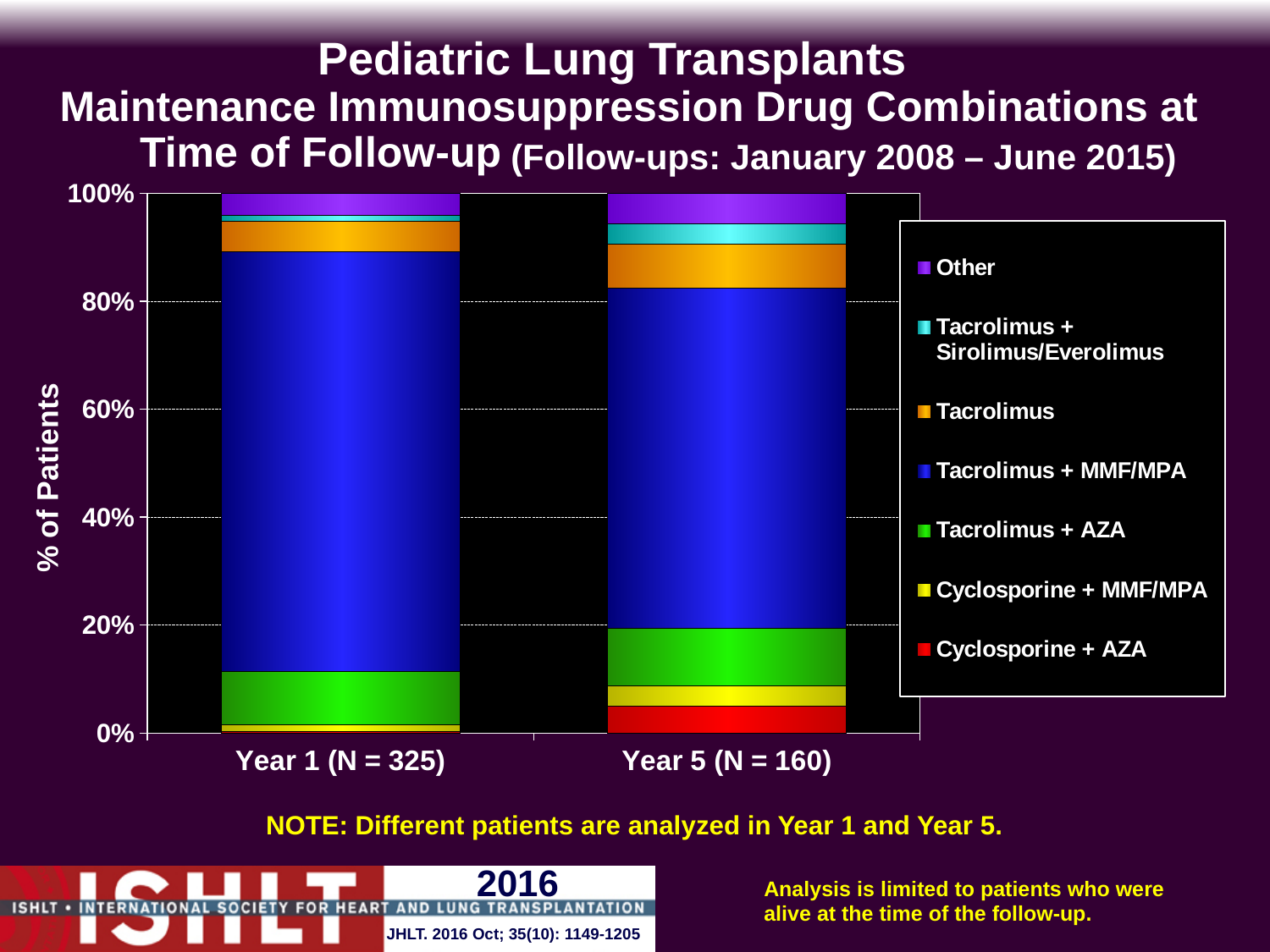
Is the share of Tacrolimus + MMF/MPA in Year 5 (N = 160) greater or less than 40%? greater How many bars (categories) are plotted on the x axis? 2 Is the share of Tacrolimus + AZA in Year 5 (N = 160) greater or less than 20%? less How many series does the legend list? 7 Does the share of Tacrolimus + MMF/MPA rise or fall from Year 1 to Year 5? fall Is the share of Cyclosporine + AZA larger in Year 1 (N = 325) or Year 5 (N = 160)? Year 5 (N = 160) Is the share of Tacrolimus + MMF/MPA larger in Year 1 (N = 325) or Year 5 (N = 160)? Year 1 (N = 325) Is the share of Tacrolimus + MMF/MPA in Year 1 (N = 325) greater or less than 60%? greater What is the label on the y axis? % of Patients Which drug combination makes up the largest segment of the Year 1 (N = 325) bar? Tacrolimus + MMF/MPA What is the total height of each stacked bar? 100% What kind of chart is shown on the slide? Stacked bar chart